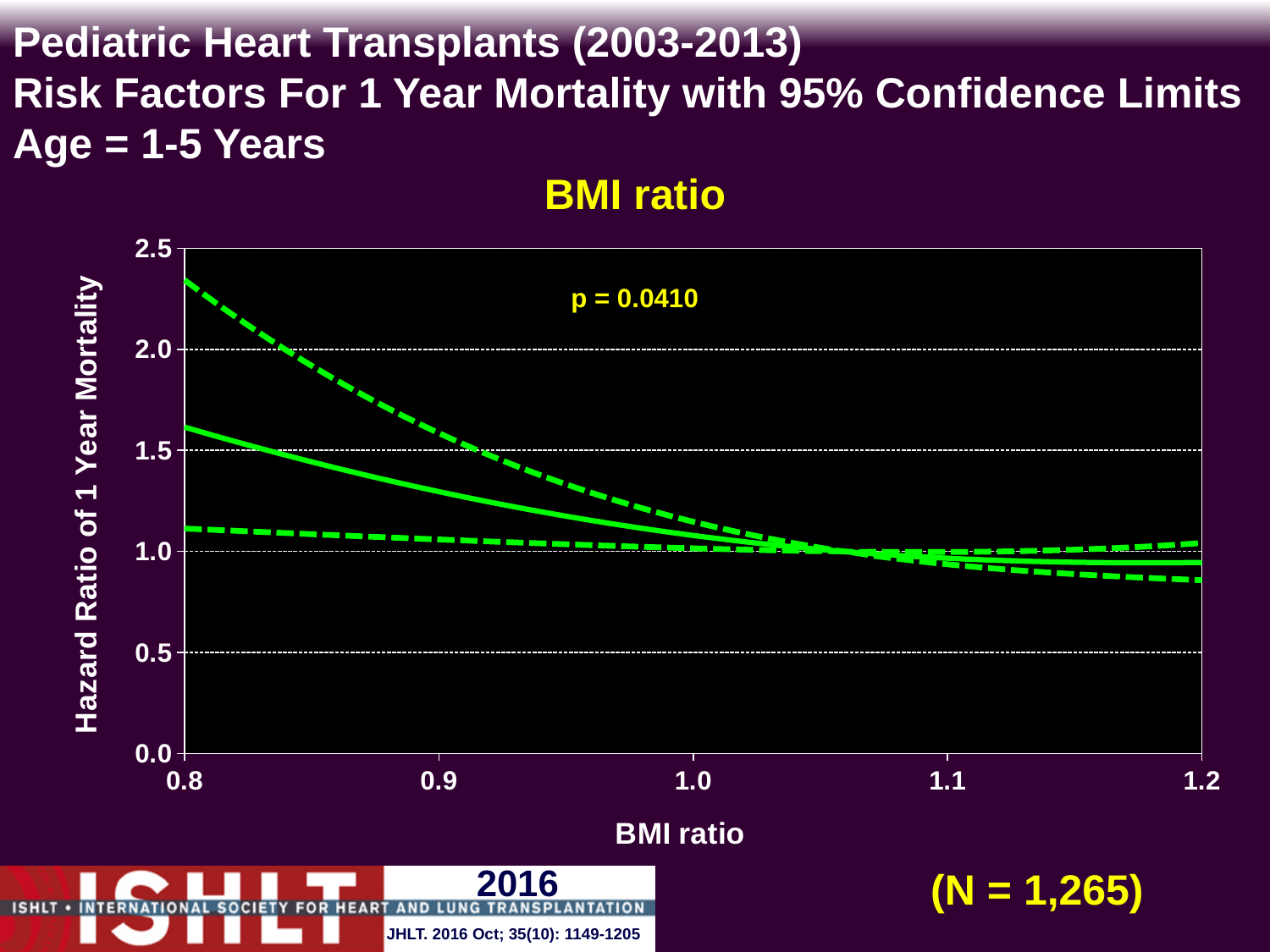
What is the highest value shown on the y axis of the chart? 2.5 What is the label of the y axis? Hazard Ratio of 1 Year Mortality Is the value of the upper dashed confidence limit at BMI ratio 0.8 greater or less than 2.0? greater What p-value is printed on the chart? p = 0.0410 Is the value of the solid hazard ratio line at BMI ratio 0.8 greater or less than 1.5? greater Is the solid hazard ratio line higher at BMI ratio 0.8 or at BMI ratio 1.2? 0.8 Is the value of the lower dashed confidence limit at BMI ratio 1.2 greater or less than 1.0? less Does the solid hazard ratio line rise or fall as BMI ratio increases from 0.8 to 1.2? fall What kind of chart is shown on the slide? line chart How many lines are plotted on the chart? 3 What is the lowest BMI ratio value shown on the x axis? 0.8